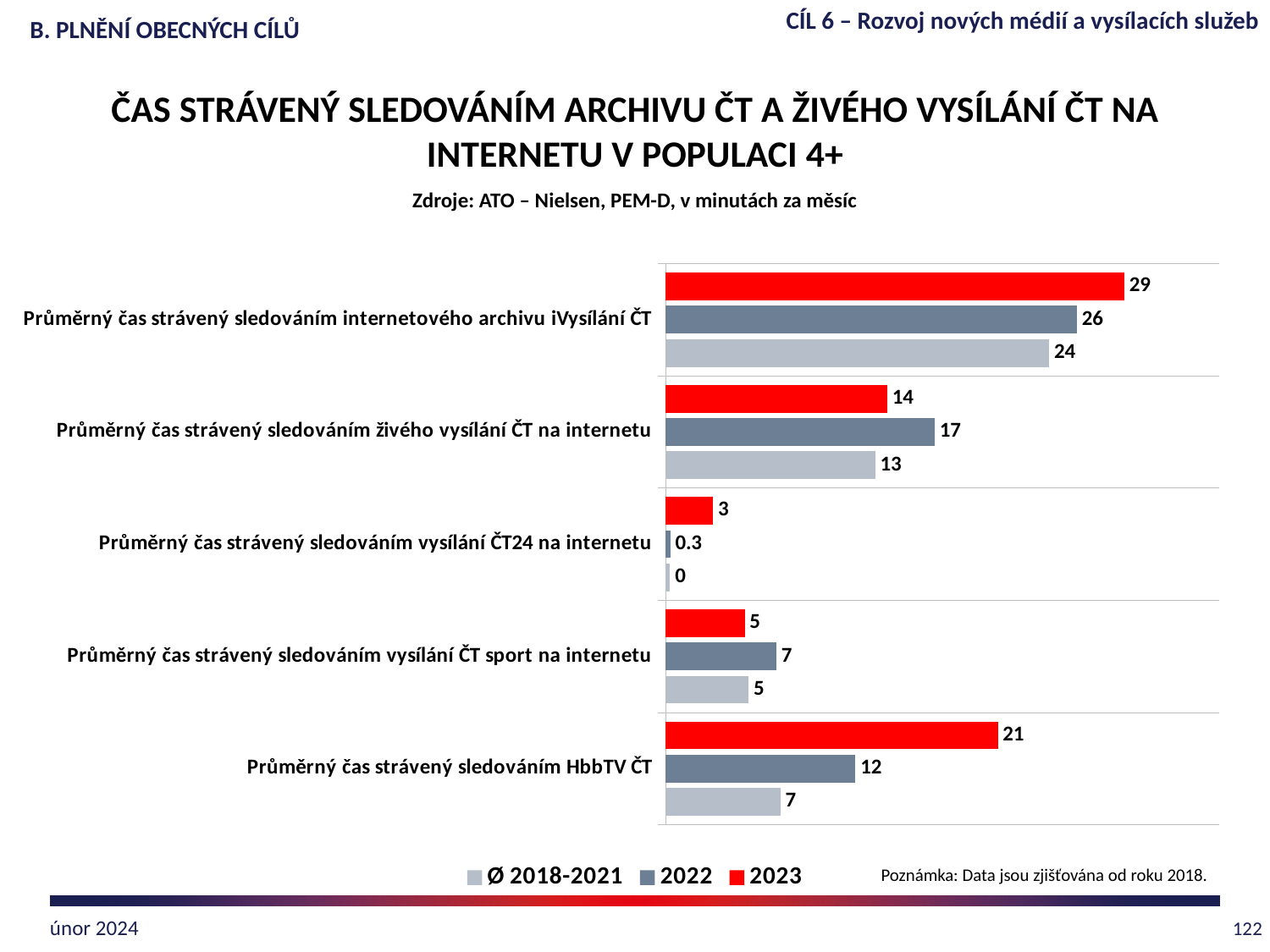
How many series does the legend list? 3 What is the 2023 value for 'Průměrný čas strávený sledováním internetového archivu iVysílání ČT'? 29 How many categories are shown on the chart? 5 Which colour represents the 2023 series in the legend? Red What is the difference between the 2023 and 2022 values for 'Průměrný čas strávený sledováním HbbTV ČT'? 9 For 'Průměrný čas strávený sledováním živého vysílání ČT na internetu', which is larger: the 2022 value or the 2023 value? 2022 What is the 2022 value for 'Průměrný čas strávený sledováním vysílání ČT24 na internetu'? 0.3 Which category has the lowest Ø 2018-2021 value? Průměrný čas strávený sledováním vysílání ČT24 na internetu What is the 2022 value for 'Průměrný čas strávený sledováním živého vysílání ČT na internetu'? 17 What is the Ø 2018-2021 value for 'Průměrný čas strávený sledováním HbbTV ČT'? 7 What kind of chart is shown on the slide? Bar chart Which category has the highest 2023 value? Průměrný čas strávený sledováním internetového archivu iVysílání ČT